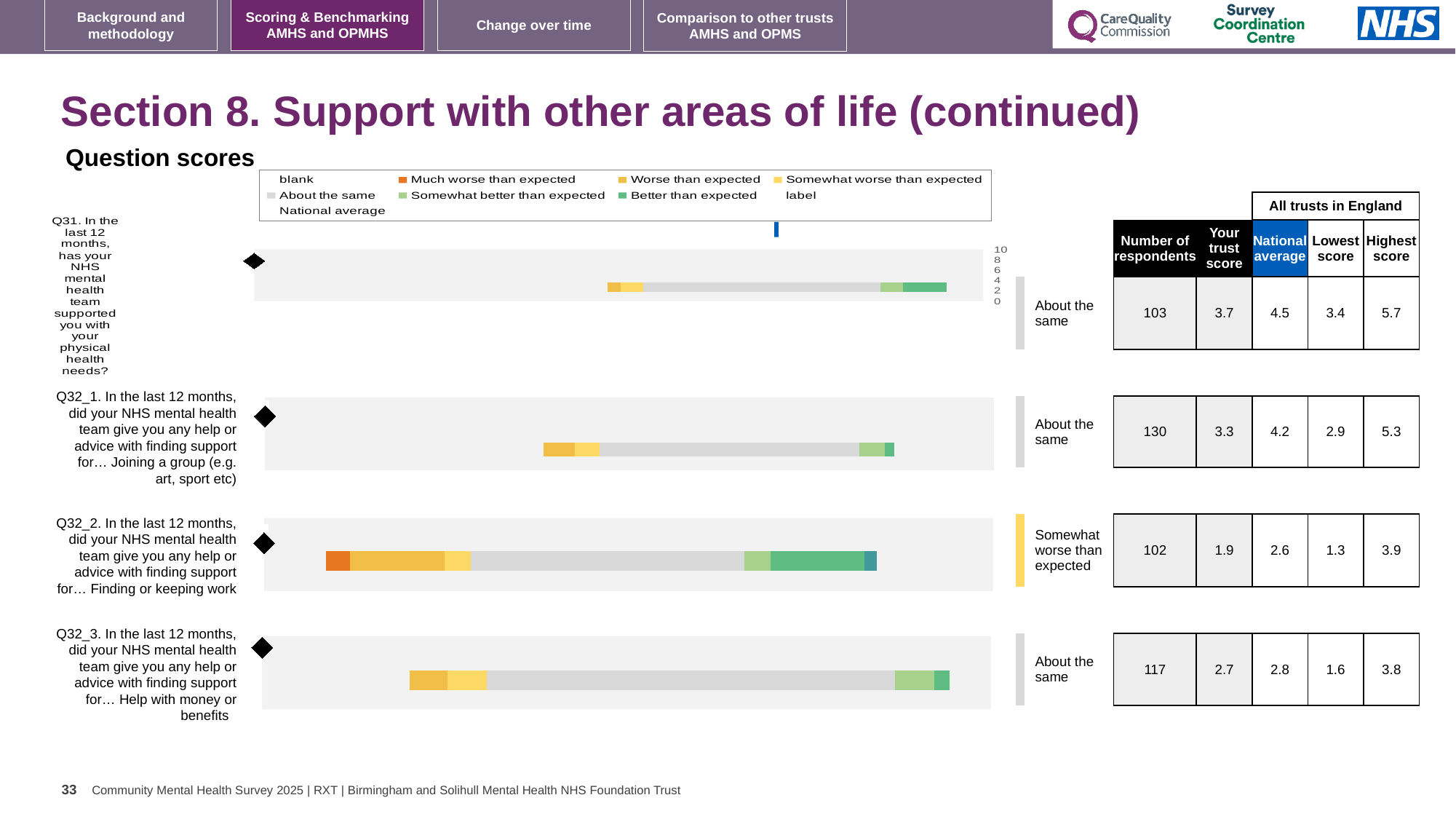
What is the number of respondents for Q31? 103 Which benchmark category is shown for Q32_2 (Finding or keeping work)? Somewhat worse than expected Which benchmark category is shown for Q31 (supported you with your physical health needs)? About the same Which question has the lowest trust score? Q32_2 (Finding or keeping work) What is the national average for Q32_2 (Finding or keeping work)? 2.6 Which question has the highest number of respondents? Q32_1 (Joining a group) What is your trust score for Q32_1 (Joining a group)? 3.3 For Q32_3 (Help with money or benefits), which is larger: your trust score or the national average? National average What is the difference between the national average and your trust score for Q31? 0.8 What is the highest score among all trusts in England for Q32_3 (Help with money or benefits)? 3.8 What kind of chart is used to show the question scores on this slide? bar chart How many questions are plotted in the question scores chart? 4